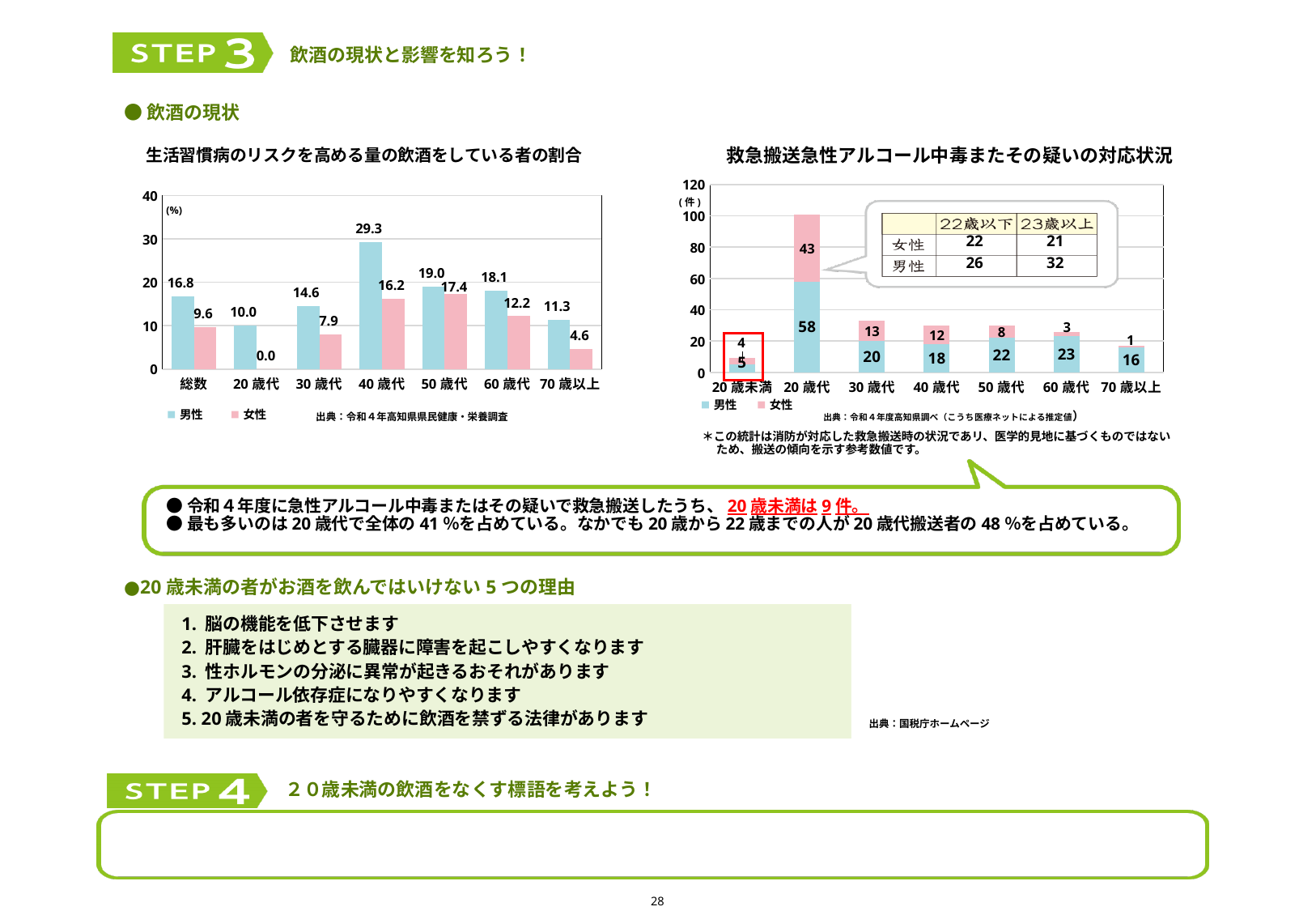
In the chart titled 救急搬送急性アルコール中毒またその疑いの対応状況, which category has the highest total? 20 歳代 In the chart titled 救急搬送急性アルコール中毒またその疑いの対応状況, what is the 女性 value for 30 歳代? 13 In the chart titled 救急搬送急性アルコール中毒またその疑いの対応状況, what is the total of the stacked bar for 20 歳未満? 9 What kind of chart is the one titled 救急搬送急性アルコール中毒またその疑いの対応状況? Stacked bar chart In the chart titled 救急搬送急性アルコール中毒またその疑いの対応状況, what is the 男性 value for 20 歳代? 58 In the chart titled 生活習慣病のリスクを高める量の飲酒をしている者の割合, which category has the lowest value for 女性? 20 歳代 In the chart titled 生活習慣病のリスクを高める量の飲酒をしている者の割合, what is the value for 女性 in the 50 歳代 category? 17.4 In the chart titled 生活習慣病のリスクを高める量の飲酒をしている者の割合, which category has the highest value for 男性? 40 歳代 In the chart titled 生活習慣病のリスクを高める量の飲酒をしている者の割合, what is the difference between the 男性 and 女性 values for 総数? 7.2 In the chart titled 救急搬送急性アルコール中毒またその疑いの対応状況, is the 男性 value for 50 歳代 or 60 歳代 larger? 60 歳代 In the chart titled 生活習慣病のリスクを高める量の飲酒をしている者の割合, what is the value for 男性 in the 40 歳代 category? 29.3 In the chart titled 生活習慣病のリスクを高める量の飲酒をしている者の割合, how many series does the legend list? 2